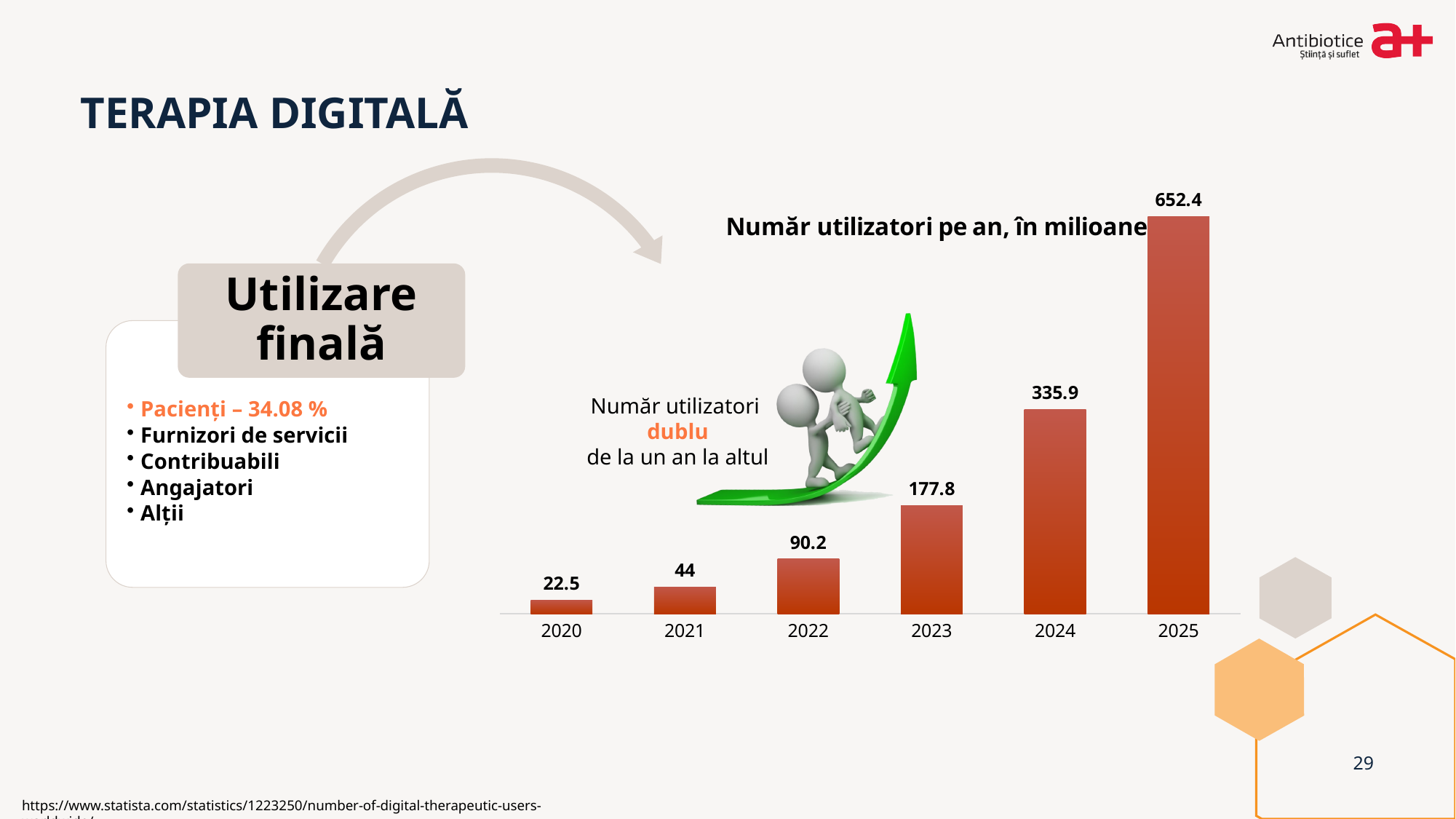
How many years are shown on the x axis of the chart? 6 What is the value shown for 2020? 22.5 What is the difference between the values for 2021 and 2020? 21.5 Which year has the highest number of users? 2025 What kind of chart is shown on the slide? bar chart What is the difference between the values for 2024 and 2023? 158.1 What value is shown for 2025 in the chart? 652.4 Which year has the lowest number of users? 2020 What is the number of users (in millions) shown for 2022? 90.2 What is the title of the chart? Număr utilizatori pe an, în milioane Which is larger, the value for 2023 or the value for 2022? 2023 Do the values rise or fall from 2020 to 2025? rise